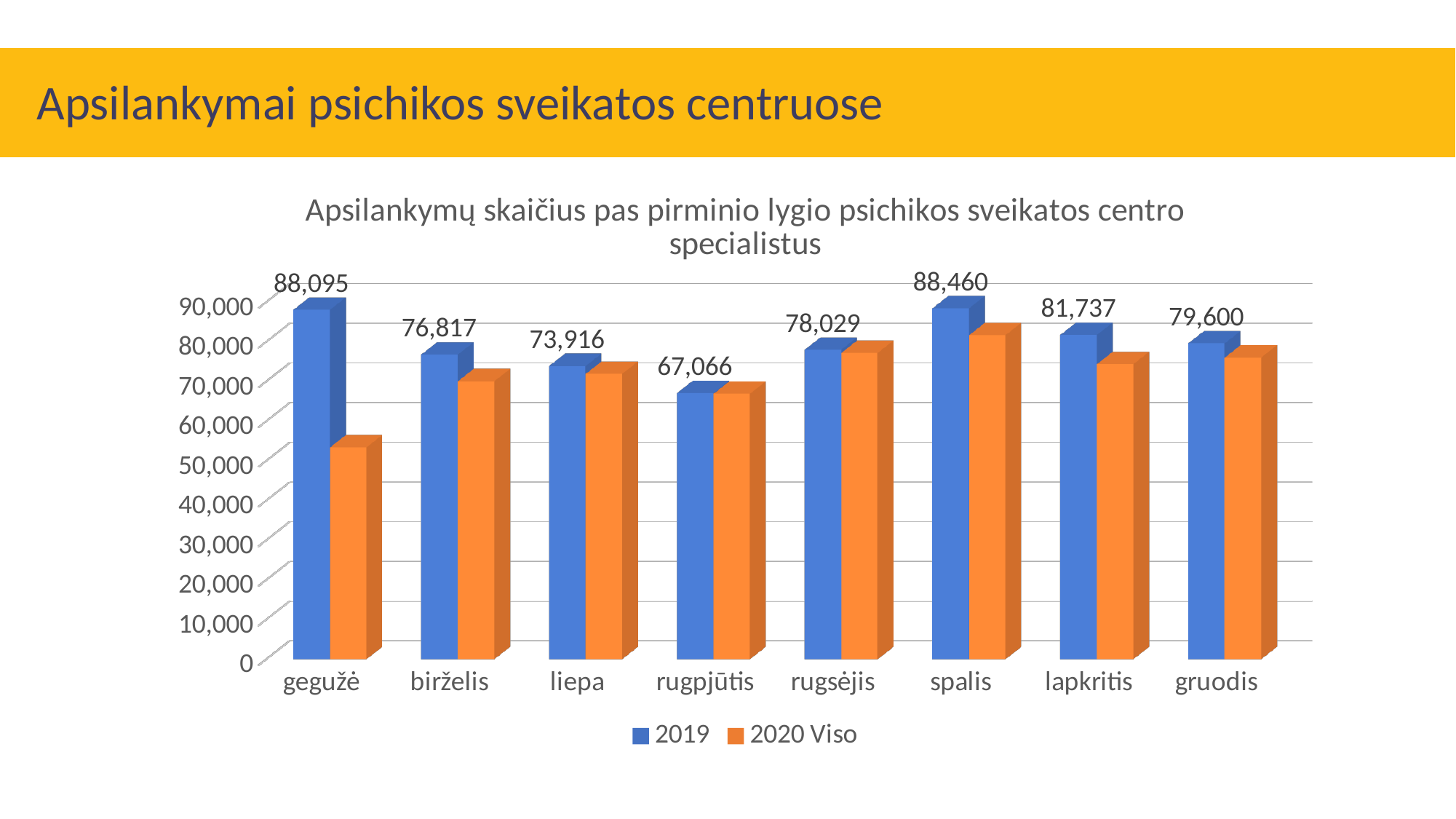
What is the difference between the 2019 values for lapkritis and gruodis? 2,137 Which month has the lowest 2019 value? rugpjūtis What is the difference between the 2019 values for spalis and gegužė? 365 How many series does the legend list? 2 Is the 2020 Viso value for gruodis greater or less than 80,000? less What is the 2019 value for rugpjūtis? 67,066 Which month has the highest 2019 value? spalis What is the 2019 value for gegužė? 88,095 Is the 2020 Viso value for gegužė greater or less than 60,000? less In gegužė, which series has the larger value, 2019 or 2020 Viso? 2019 What is the 2019 value for lapkritis? 81,737 How many months are shown on the x axis? 8